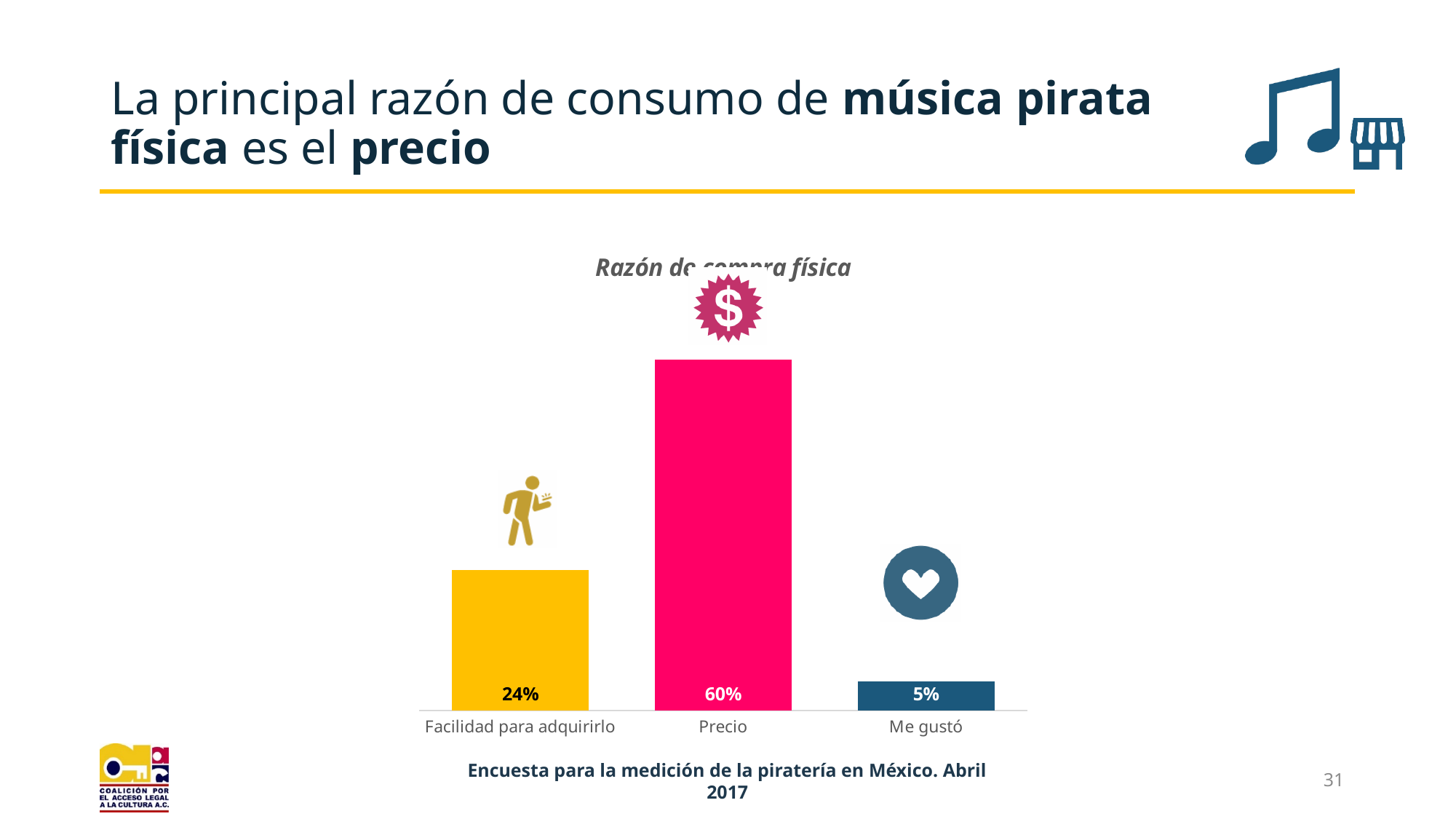
Which is larger, the value for Facilidad para adquirirlo or the value for Me gustó? Facilidad para adquirirlo What is the value for Me gustó? 5% What kind of chart is shown on the slide? Bar chart Which category has the lowest value? Me gustó What is the source text shown below the chart? Encuesta para la medición de la piratería en México. Abril 2017 How many categories are shown in the chart? 3 What is the value for Facilidad para adquirirlo? 24% What is the difference between the values for Precio and Facilidad para adquirirlo? 36% What colour is the bar for Precio? Pink What is the value for Precio? 60% What is the difference between the values for Facilidad para adquirirlo and Me gustó? 19% Which category has the highest value? Precio